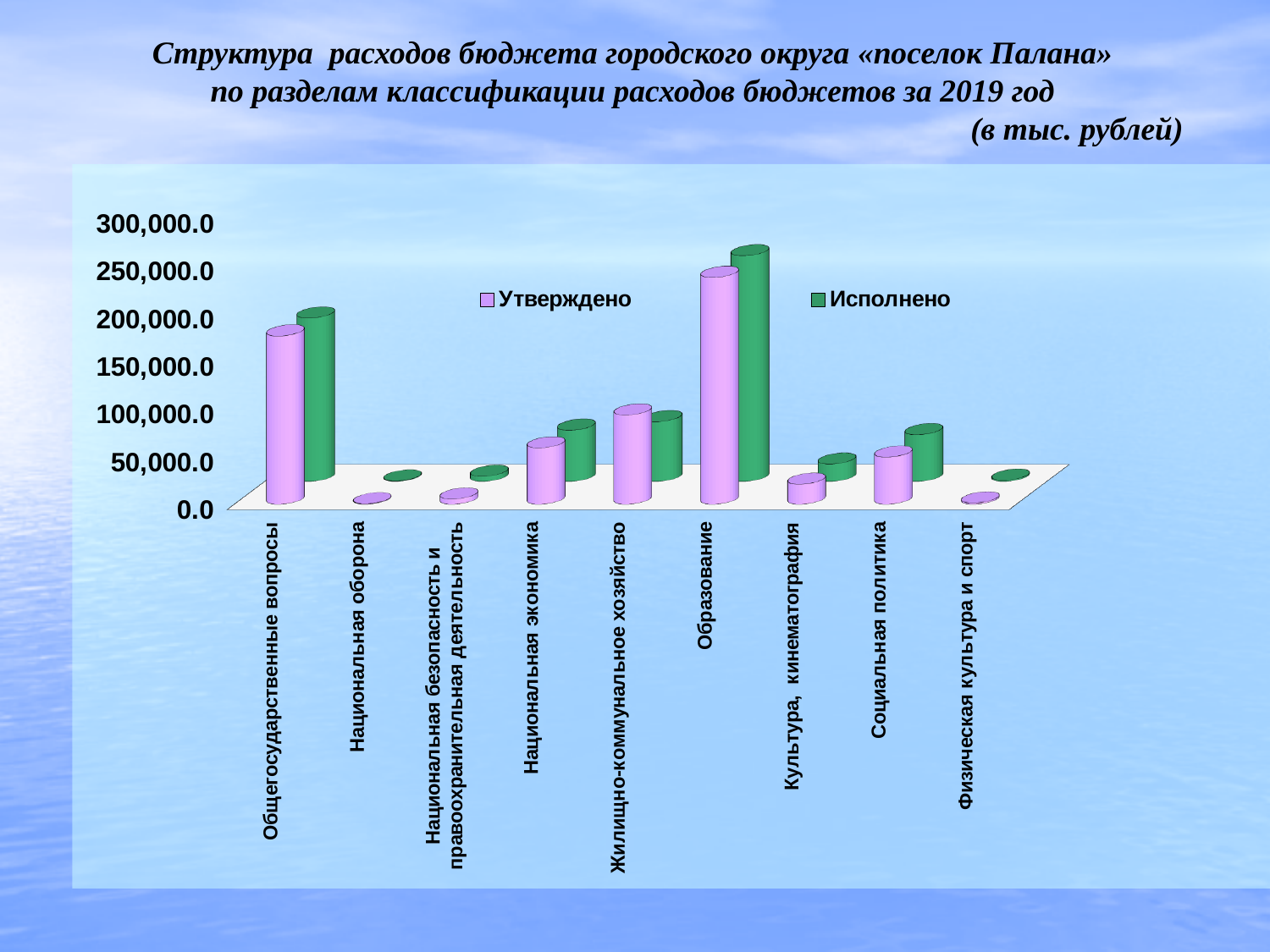
Is the Исполнено value for Национальная оборона greater or less than 50,000.0? less Is the Утверждено value for Социальная политика greater or less than 100,000.0? less Is the Утверждено value for Общегосударственные вопросы greater or less than 150,000.0? greater How many series does the legend list? 2 What kind of chart is shown on the slide? bar chart How many expenditure categories are shown along the x axis? 9 For the Утверждено series, which is larger: Жилищно-коммунальное хозяйство or Национальная экономика? Жилищно-коммунальное хозяйство What colour are the bars for the Исполнено series? green For the Утверждено series, which is larger: Социальная политика or Культура, кинематография? Социальная политика Which category has the highest value for the Утверждено series? Образование Which category has the highest value for the Исполнено series? Образование